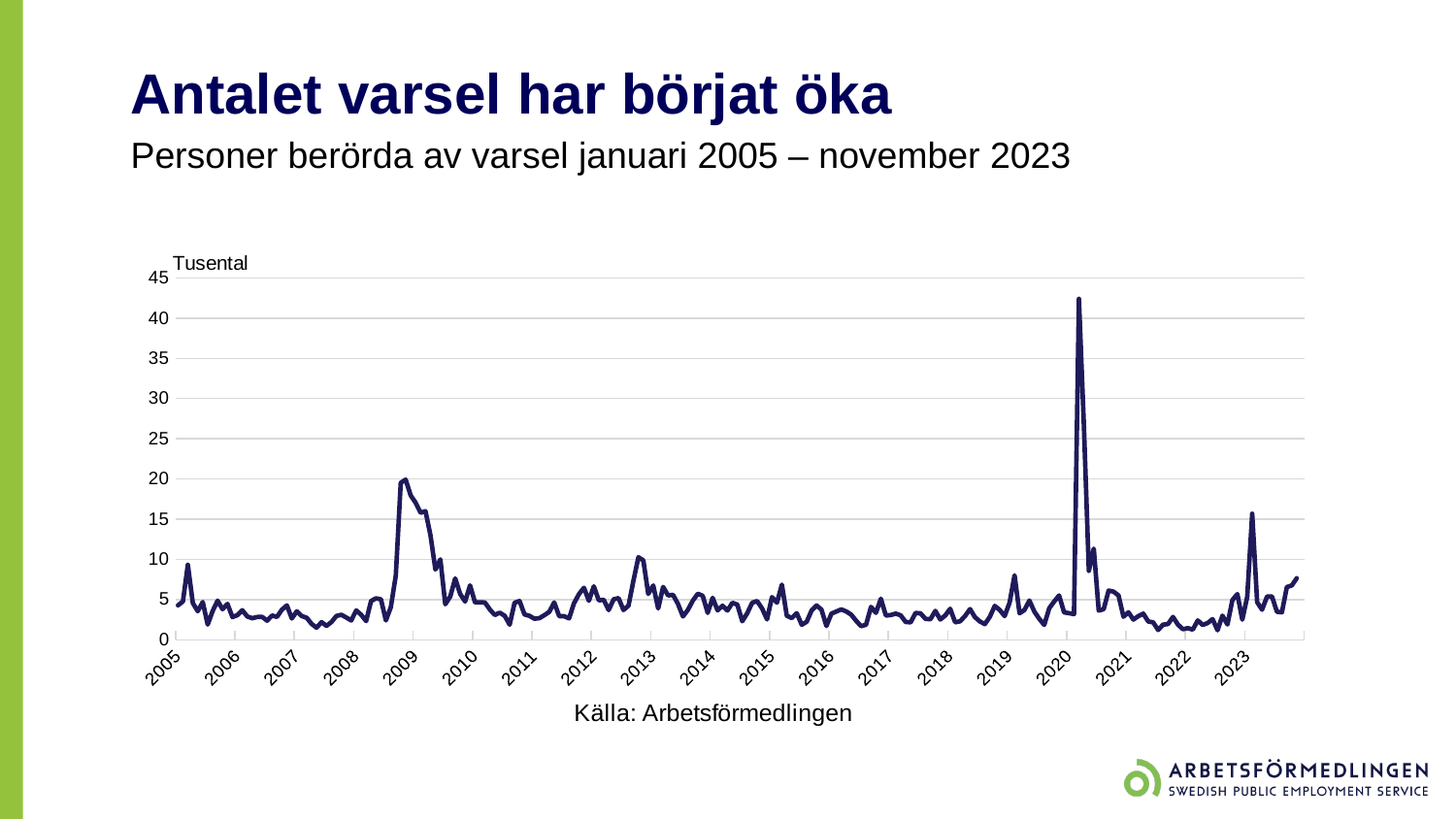
How many year labels are shown on the horizontal axis? 19 Is the peak of the line in 2023 greater or less than 10? greater Which peak is higher, the one in 2009 or the one in 2013? 2009 What is the highest value shown on the vertical axis? 45 In which year does the line reach its highest peak? 2020 What unit label is shown at the top of the vertical axis? Tusental Is the peak of the line in 2009 greater or less than 15? greater What is the title of the chart on the slide? Antalet varsel har börjat öka Which peak is higher, the one in 2009 or the one in 2020? 2020 Is the highest peak of the line in 2020 greater or less than 40? greater What kind of chart is shown on the slide? line chart Does the line rise or fall over the final months shown in 2023? rise